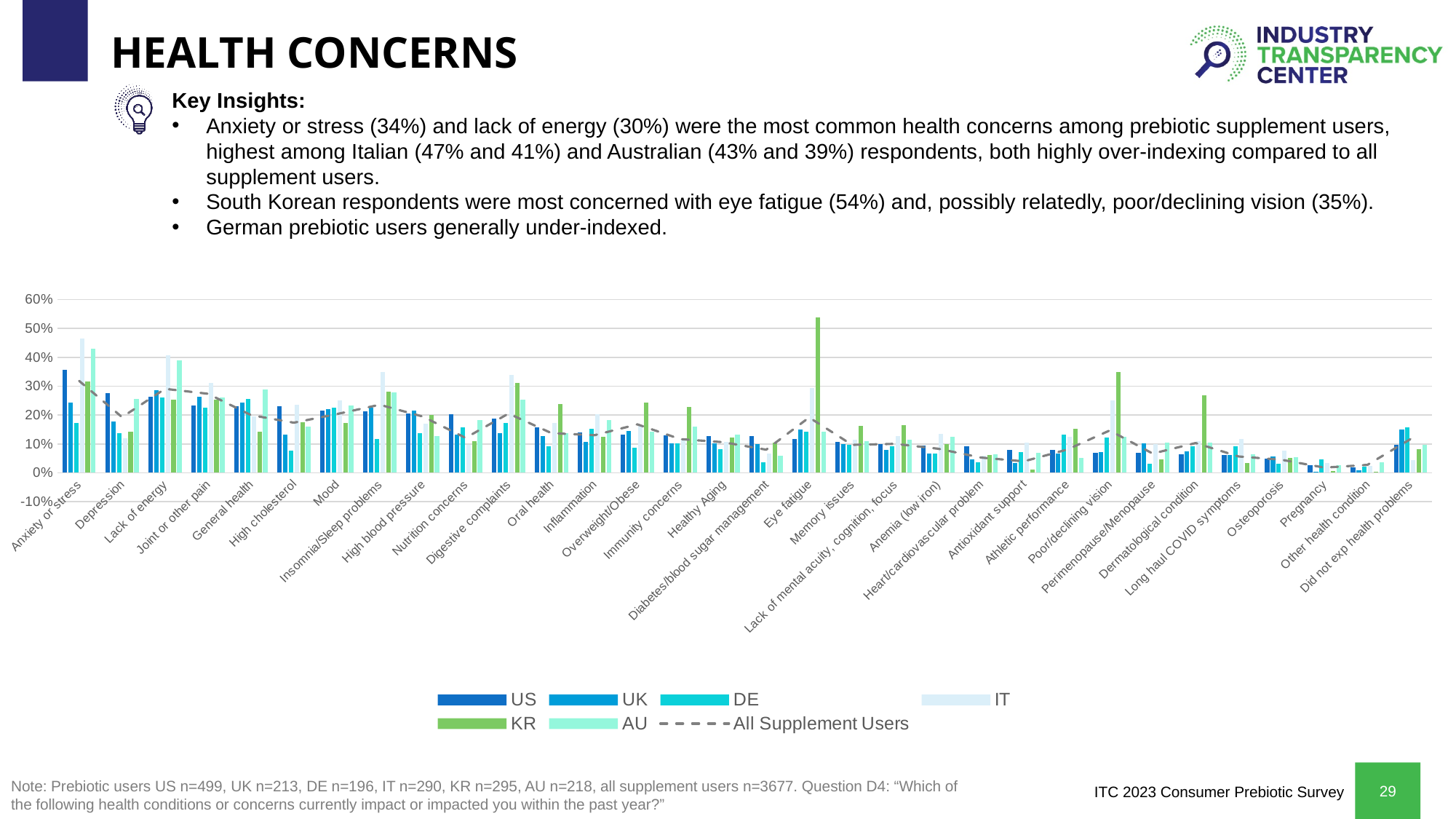
Is the US value for Anxiety or stress greater or less than 30%? greater Is the KR value for Eye fatigue greater or less than 50%? greater Which category has the single tallest bar in the chart? Eye fatigue Which series is drawn as a dashed line rather than bars? All Supplement Users What kind of chart is shown on the slide? combination bar and line chart Is the KR value for Poor/declining vision greater or less than 30%? greater How many series does the chart legend list? 7 How many health concern categories are shown along the x axis? 32 Which is larger for the US: Anxiety or stress or Depression? Anxiety or stress Which country has the tallest bar for Eye fatigue? KR Does the All Supplement Users dashed line generally rise or fall from left to right across the categories? fall